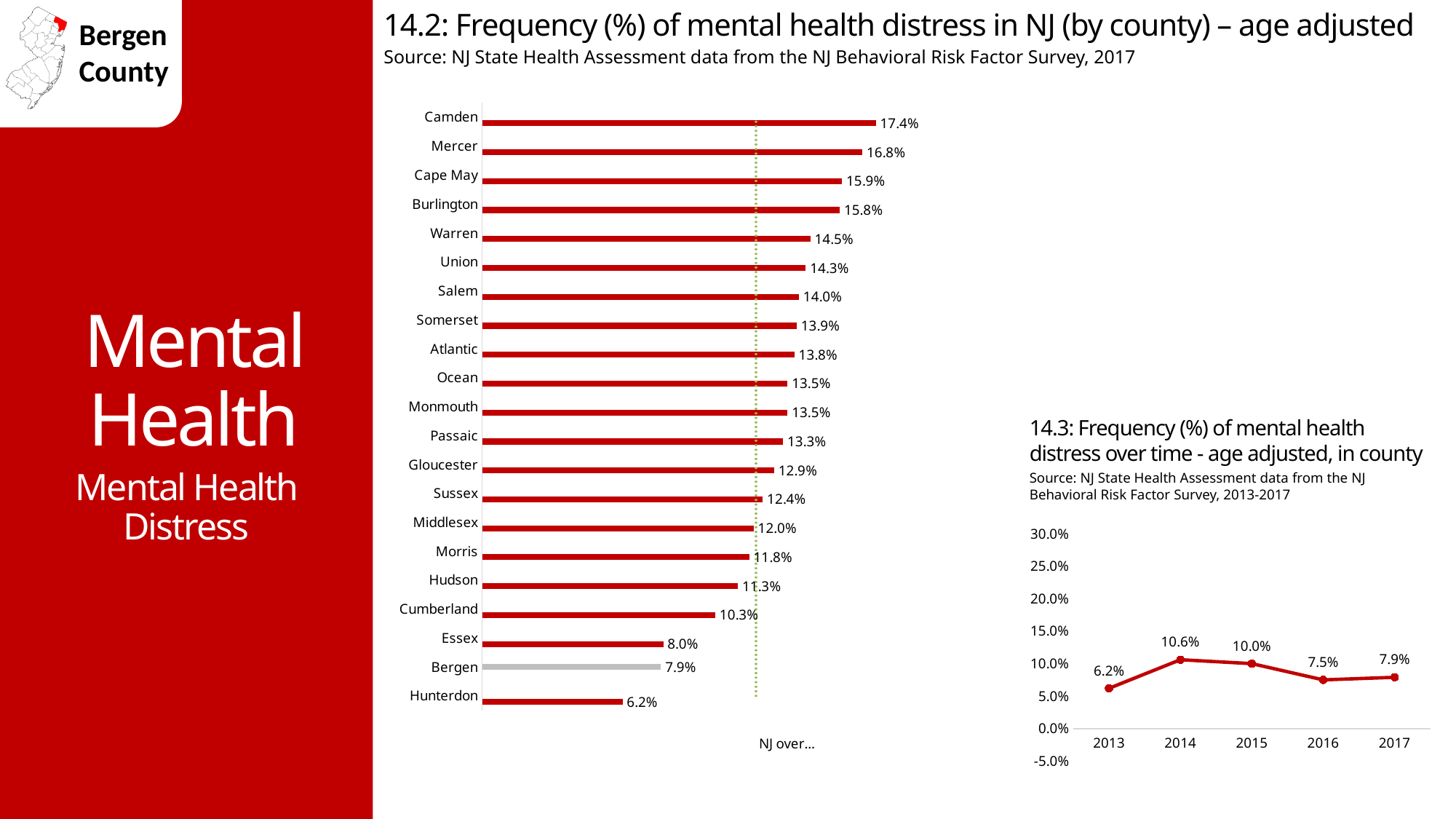
What kind of chart is chart 14.2 (by county)? Bar chart In the chart 14.2 (by county), what is the difference between Camden and Bergen? 9.5% What kind of chart is chart 14.3 (over time)? Line chart In the chart 14.2 (by county), how many counties are plotted? 21 In the chart 14.2 (by county), what is the value for Middlesex? 12.0% In the chart 14.3 (over time), what is the difference between 2014 and 2017? 2.7% In the chart 14.3 (over time), what is the value for 2014? 10.6% In the chart 14.2 (by county), which county has the highest value? Camden In the chart 14.2 (by county), what is the value for Bergen? 7.9% In the chart 14.2 (by county), which is larger, the value for Essex or the value for Cumberland? Cumberland In the chart 14.2 (by county), which county has the lowest value? Hunterdon In the chart 14.3 (over time), which year has the lowest value? 2013